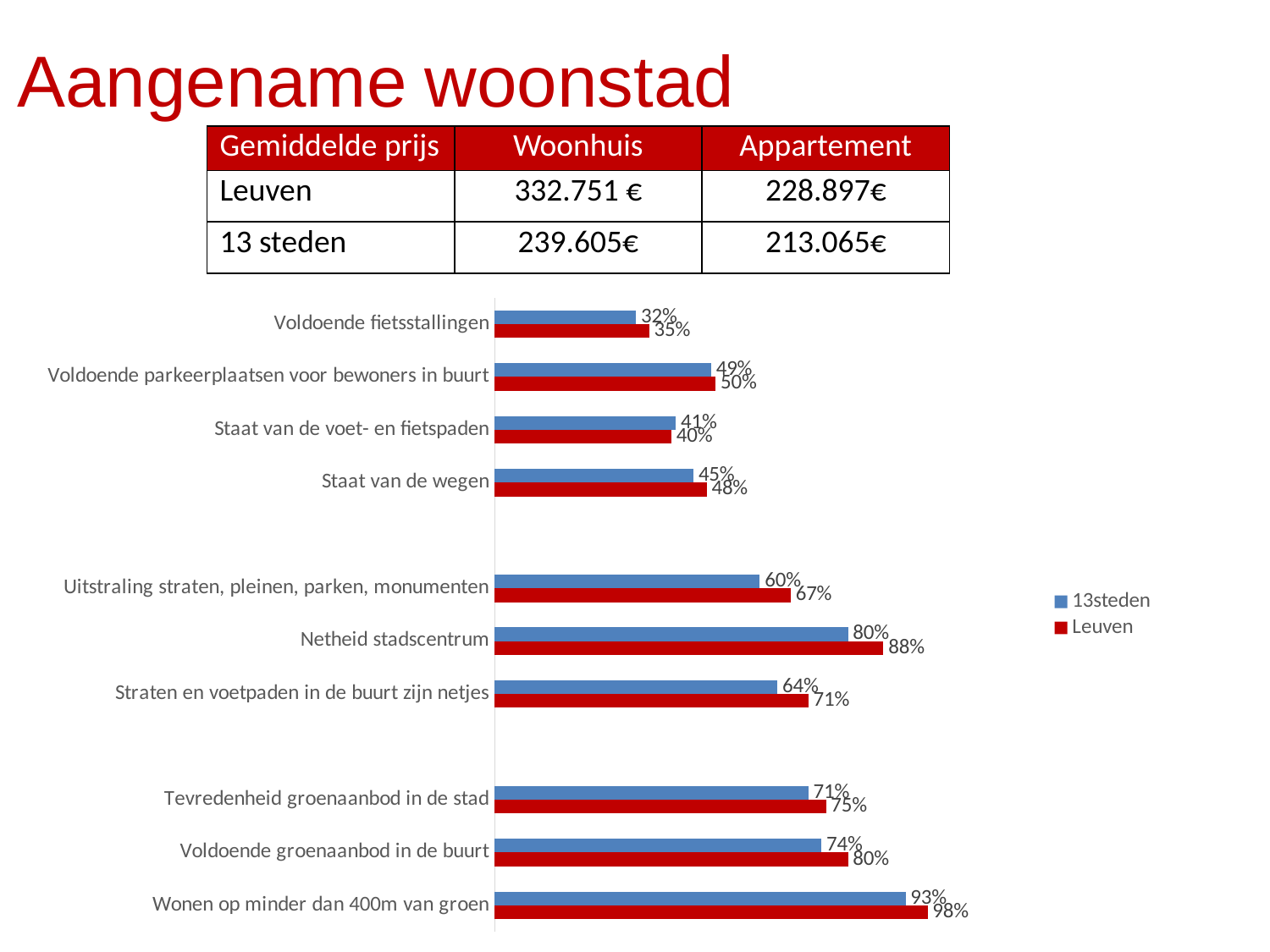
What is the Leuven value for Staat van de wegen? 48% What is the difference between the Leuven and 13steden values for Straten en voetpaden in de buurt zijn netjes? 7% What is the 13steden value for Uitstraling straten, pleinen, parken, monumenten? 60% What is the 13steden value for Wonen op minder dan 400m van groen? 93% What is the difference between the Leuven and 13steden values for Netheid stadscentrum? 8% Which category has the lowest 13steden value? Voldoende fietsstallingen How many series does the legend list? 2 What kind of chart is shown on the slide? Bar chart For Voldoende groenaanbod in de buurt, which series has the larger value, 13steden or Leuven? Leuven What is the Leuven value for Netheid stadscentrum? 88% Which category has the highest Leuven value? Wonen op minder dan 400m van groen Which colour represents the Leuven series in the chart? Red